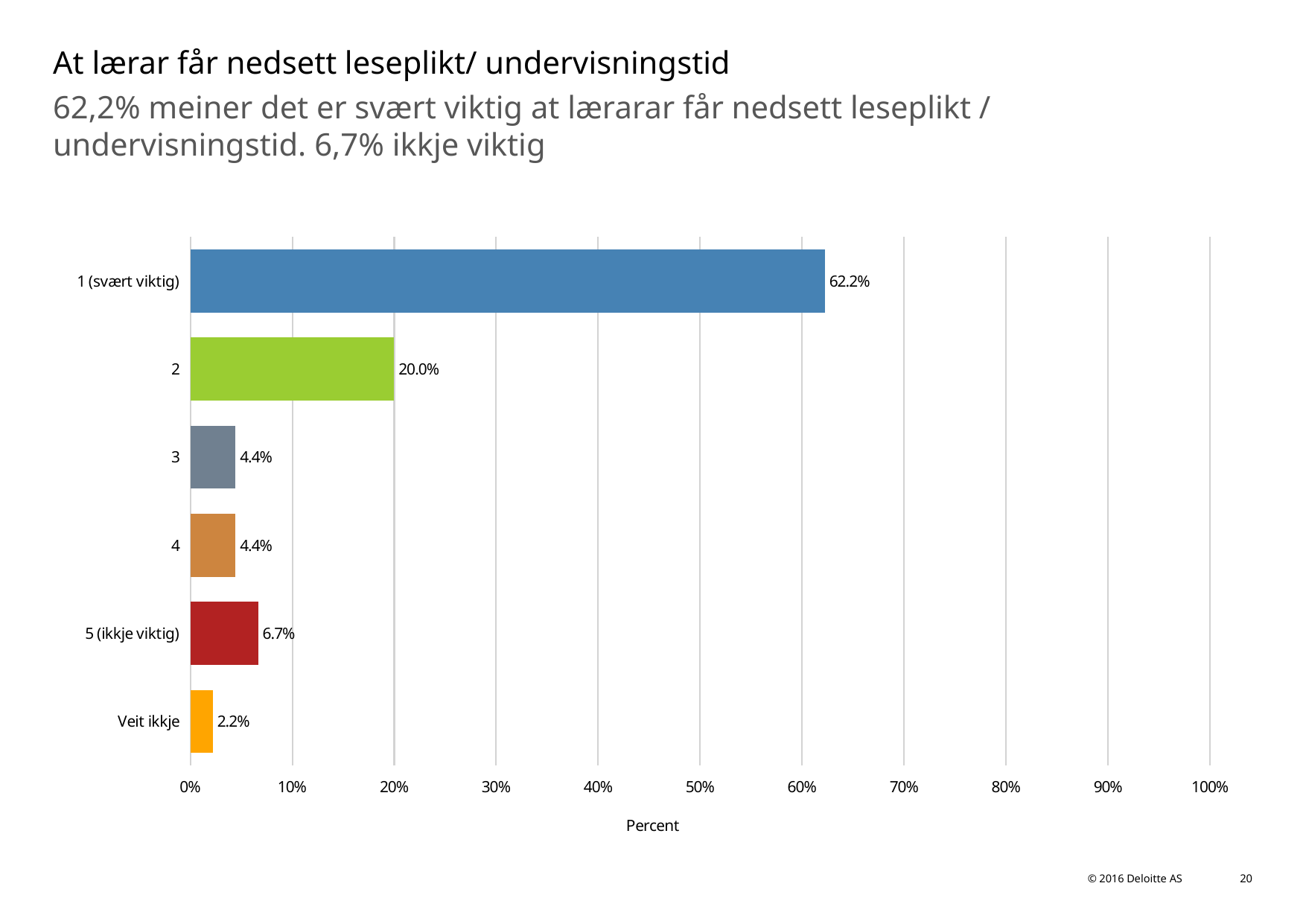
Which category has the lowest value? Veit ikkje Is the value for "1 (svært viktig)" greater or less than 50%? greater How many categories are shown in the chart? 6 What is the value for the category "2"? 20.0% What is the value for the category "1 (svært viktig)"? 62.2% What is the value for the category "5 (ikkje viktig)"? 6.7% What kind of chart is shown on the slide? Bar chart What is the value for the category "Veit ikkje"? 2.2% Which category has the highest value? 1 (svært viktig) What is the difference between the values for "1 (svært viktig)" and "2"? 42.2% Which is larger, the value for "2" or the value for "5 (ikkje viktig)"? 2 What is the difference between the values for "5 (ikkje viktig)" and "Veit ikkje"? 4.5%